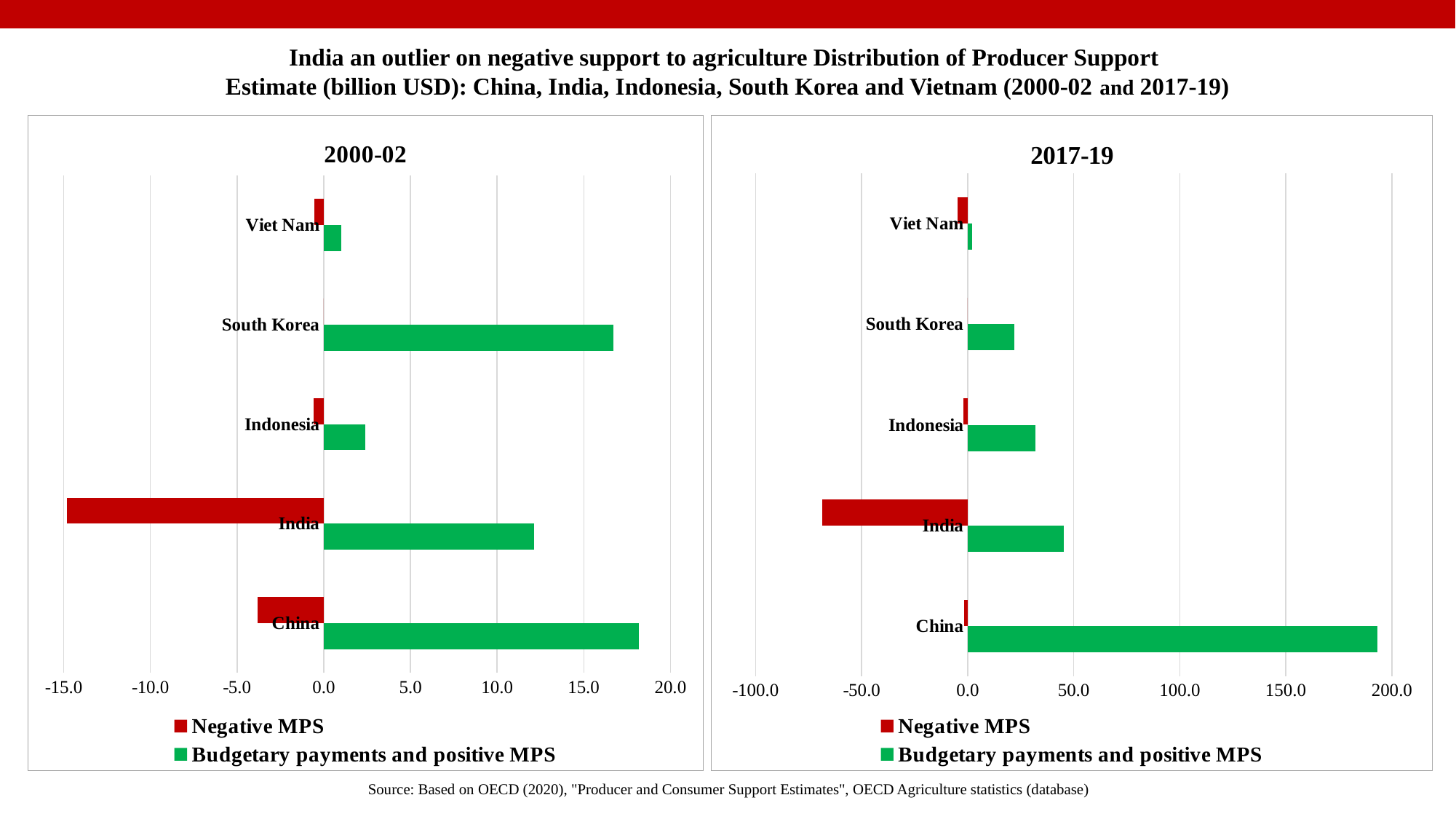
In the 2017-19 chart, is the Negative MPS value for India greater or less than -50.0? less In the 2017-19 chart, which country has the largest Budgetary payments and positive MPS bar? China What type of chart is the 2000-02 chart? bar chart In the 2000-02 chart, is the Budgetary payments and positive MPS value for China greater or less than 15.0? greater How many countries are shown in the 2017-19 chart? 5 In the 2000-02 chart, is the Negative MPS value for India greater or less than -10.0? less In the 2000-02 chart, which has the larger Budgetary payments and positive MPS bar, India or Indonesia? India What colour represents Negative MPS in the charts? red How many series does the legend of the 2000-02 chart list? 2 In the 2017-19 chart, which has the larger Budgetary payments and positive MPS bar, India or South Korea? India In the 2000-02 chart, which country has the most negative Negative MPS bar? India